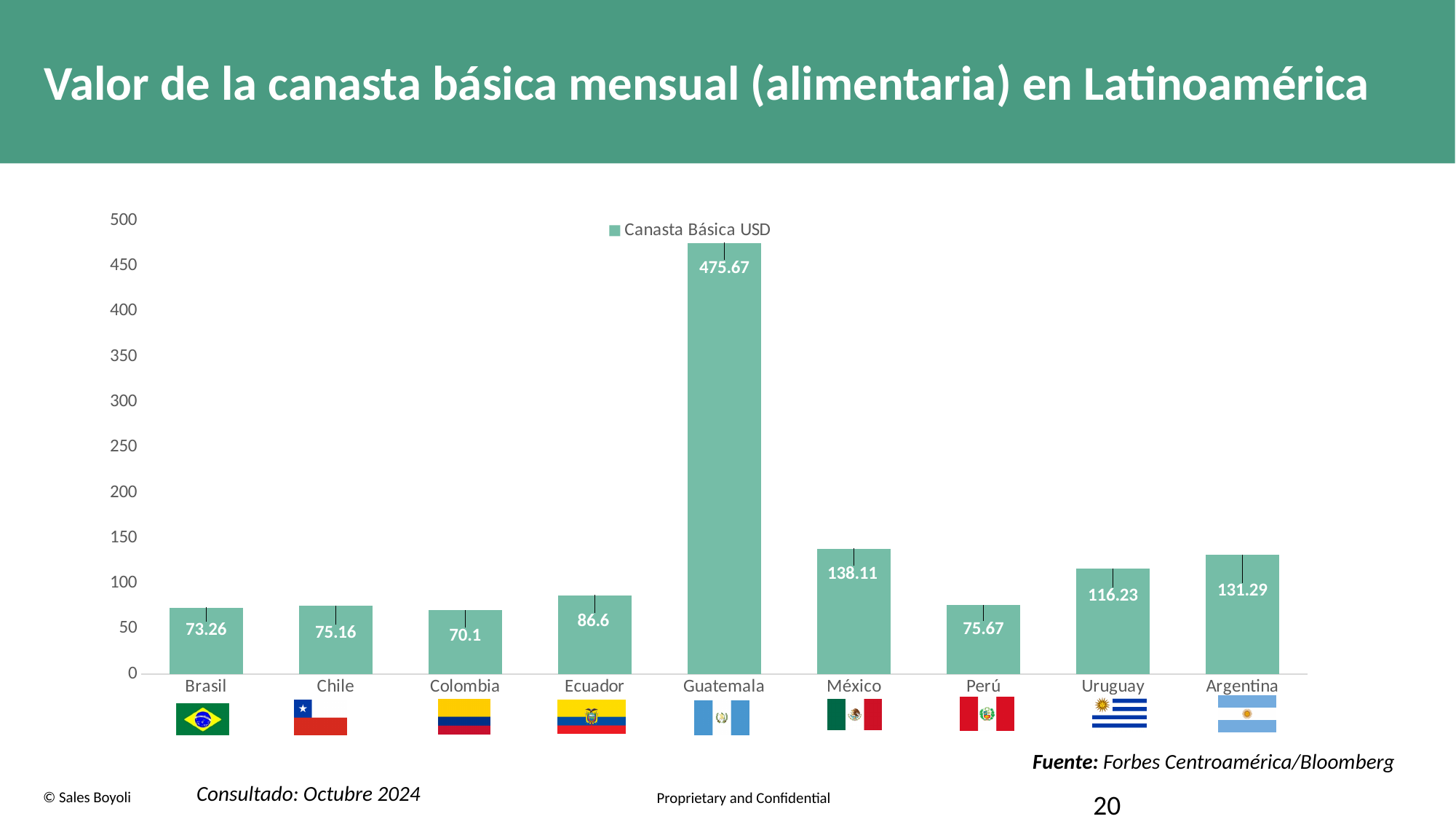
How many series does the legend list? 1 Which country has the highest basic basket value? Guatemala What is the value shown for México? 138.11 What kind of chart is shown on the slide? Bar chart What is the value of the basic food basket for Guatemala? 475.67 Which country has the lowest basic basket value? Colombia Is the value for Uruguay greater or less than 100? greater What is the difference between the values for Argentina and Uruguay? 15.06 What is the value shown for Colombia? 70.1 How many countries are shown on the chart? 9 What is the legend entry of the chart? Canasta Básica USD Which has a larger value, Ecuador or Perú? Ecuador